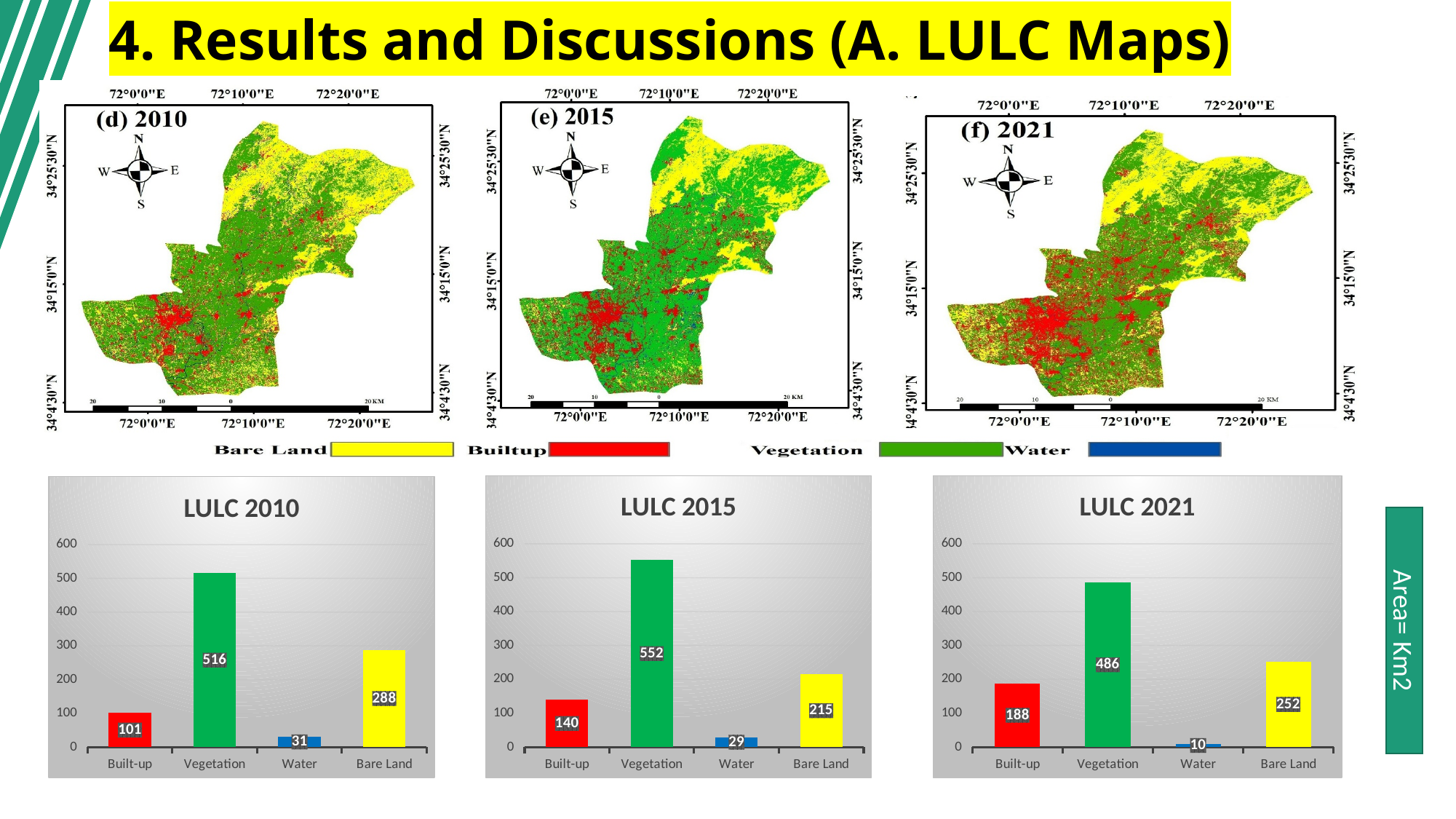
In the LULC 2010 chart, what is the value for Vegetation? 516 In the LULC 2021 chart, what is the value for Water? 10 In the LULC 2015 chart, what is the difference between Vegetation and Bare Land? 337 In the LULC 2021 chart, which category has the highest value? Vegetation In the LULC 2010 chart, which category has the lowest value? Water What kind of chart is LULC 2010? bar chart In the LULC 2021 chart, what is the difference between Built-up and Water? 178 In the LULC 2010 chart, is the value for Bare Land greater or less than 200? greater What colour is the Bare Land bar in the LULC 2015 chart? yellow How many categories are shown in the LULC 2015 chart? 4 In the LULC 2021 chart, which is larger, Built-up or Bare Land? Bare Land In the LULC 2015 chart, what is the value for Built-up? 140